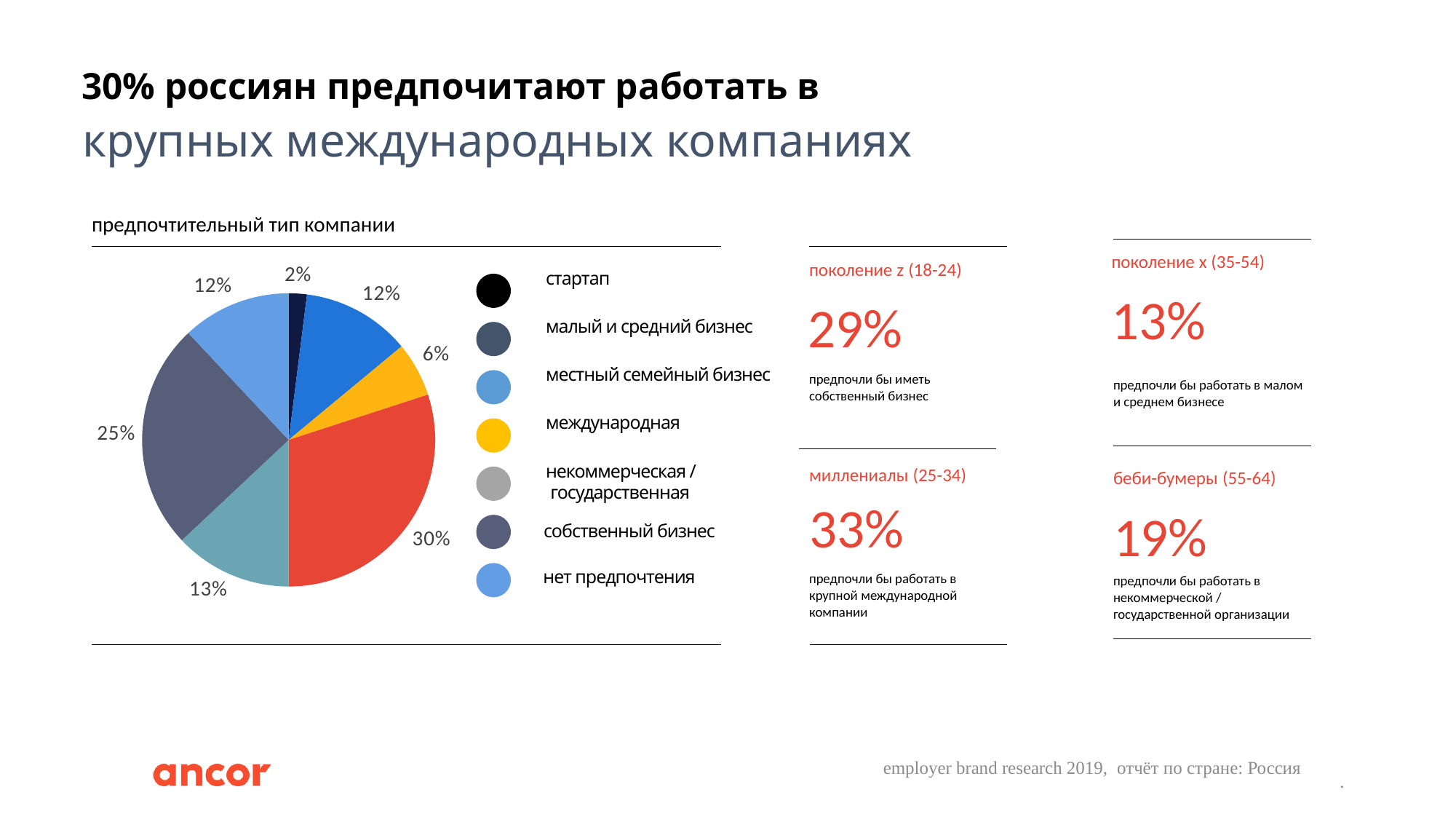
What is the smallest slice value shown on the pie chart? 2% How many entries does the legend of the pie chart list? 7 Which is larger on the pie chart: the 25% slice or the 13% slice? the 25% slice What is the difference between the 25% slice and the 13% slice on the pie chart? 12% How many slices does the pie chart have? 7 What share of the pie chart is labelled for "стартап" (the black slice)? 2% What colour is the legend marker for "международная" in the pie chart legend? yellow What share of the pie chart is labelled for "собственный бизнес" (the dark slate slice)? 25% What is the largest slice value shown on the pie chart? 30% What is the difference between the largest slice (30%) and the smallest slice (2%) of the pie chart? 28% What is the title of the pie chart? предпочтительный тип компании What kind of chart is shown under the heading "предпочтительный тип компании"? pie chart